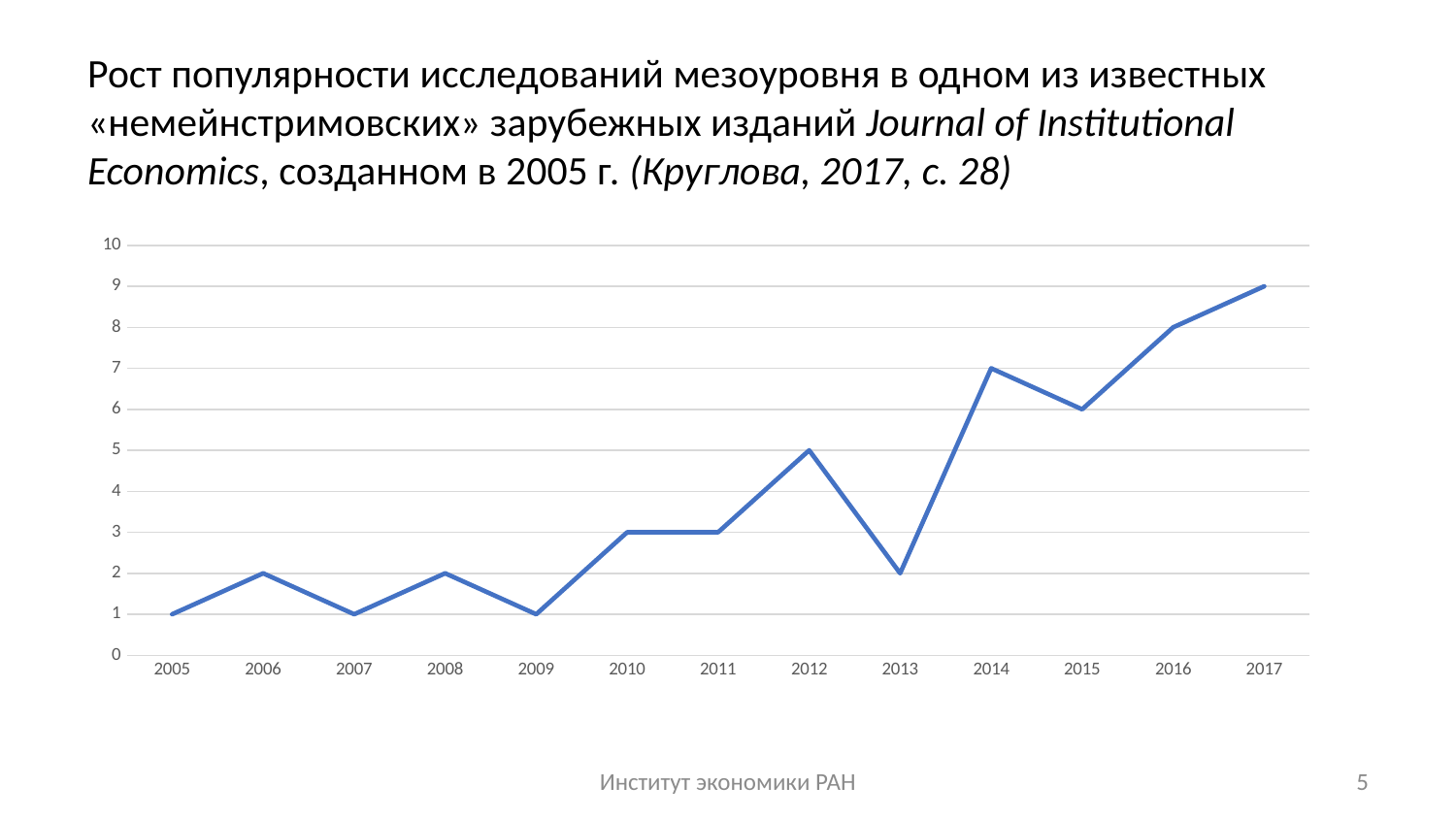
What kind of chart is shown on the slide? line chart What is the difference between the values for 2014 and 2013? 5 What is the value for 2017? 9 Is the value for 2016 greater or less than 5? greater Which is larger, the value for 2015 or the value for 2016? 2016 Which year has the highest value? 2017 Overall, do the values rise or fall from 2005 to 2017? rise What is the value for 2013? 2 What is the difference between the values for 2017 and 2005? 8 What is the value for 2014? 7 How many years are plotted on the x axis? 13 What is the value for 2012? 5